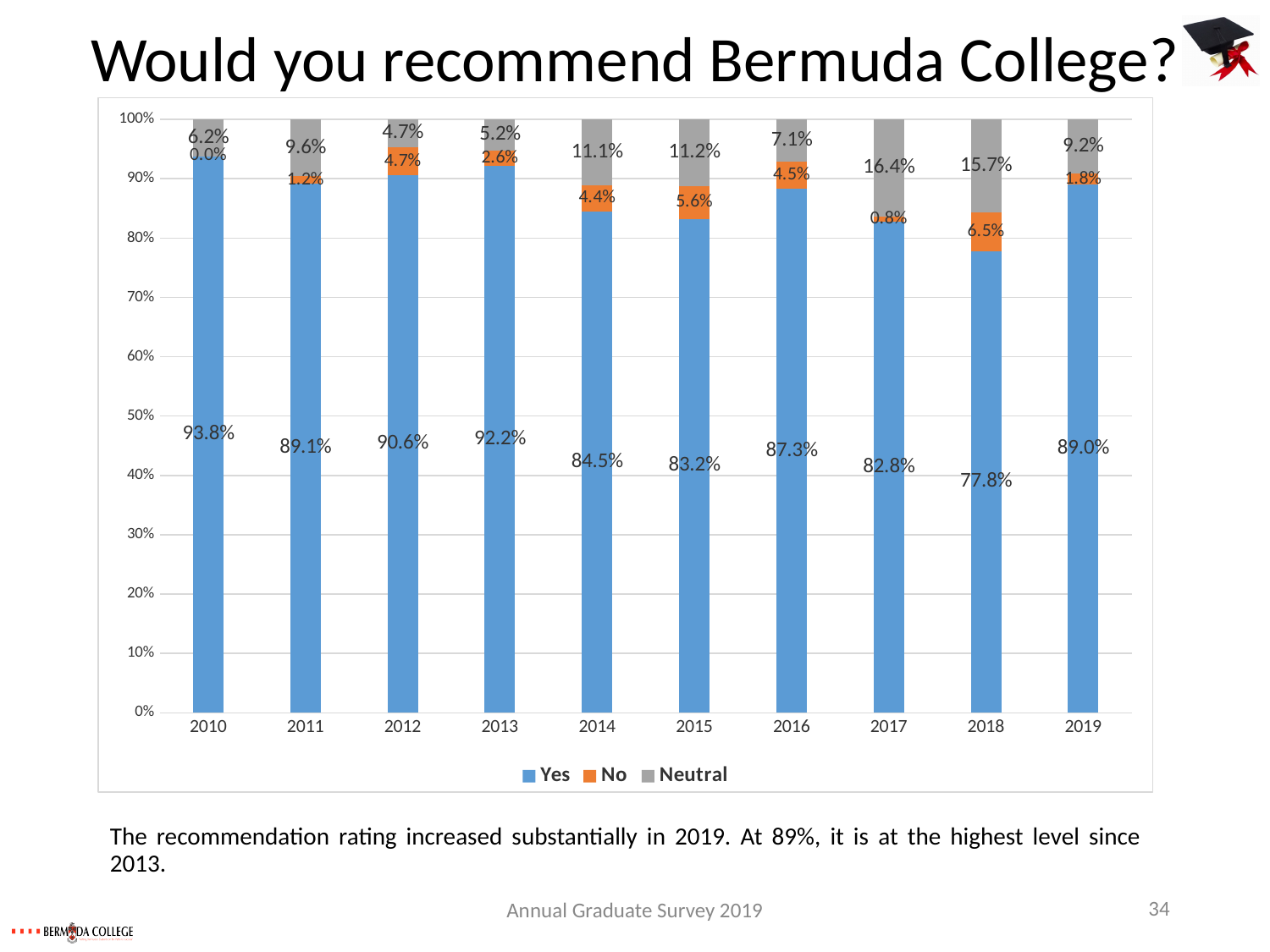
Which year had a larger Neutral share, 2014 or 2017? 2017 What is the Neutral percentage for 2017? 16.4% By how many percentage points did the Yes share rise from 2018 to 2019? 11.2 percentage points Did the Yes percentage rise or fall from 2013 to 2018? Fall In which year was the Yes percentage highest? 2010 What kind of chart is shown on the slide? Stacked bar chart How many series does the legend list? 3 What is the title of the chart? Would you recommend Bermuda College? In which year was the Yes percentage lowest? 2018 What is the No percentage for 2018? 6.5% How many years are shown on the x axis? 10 What percentage of respondents answered Yes in 2019? 89.0%